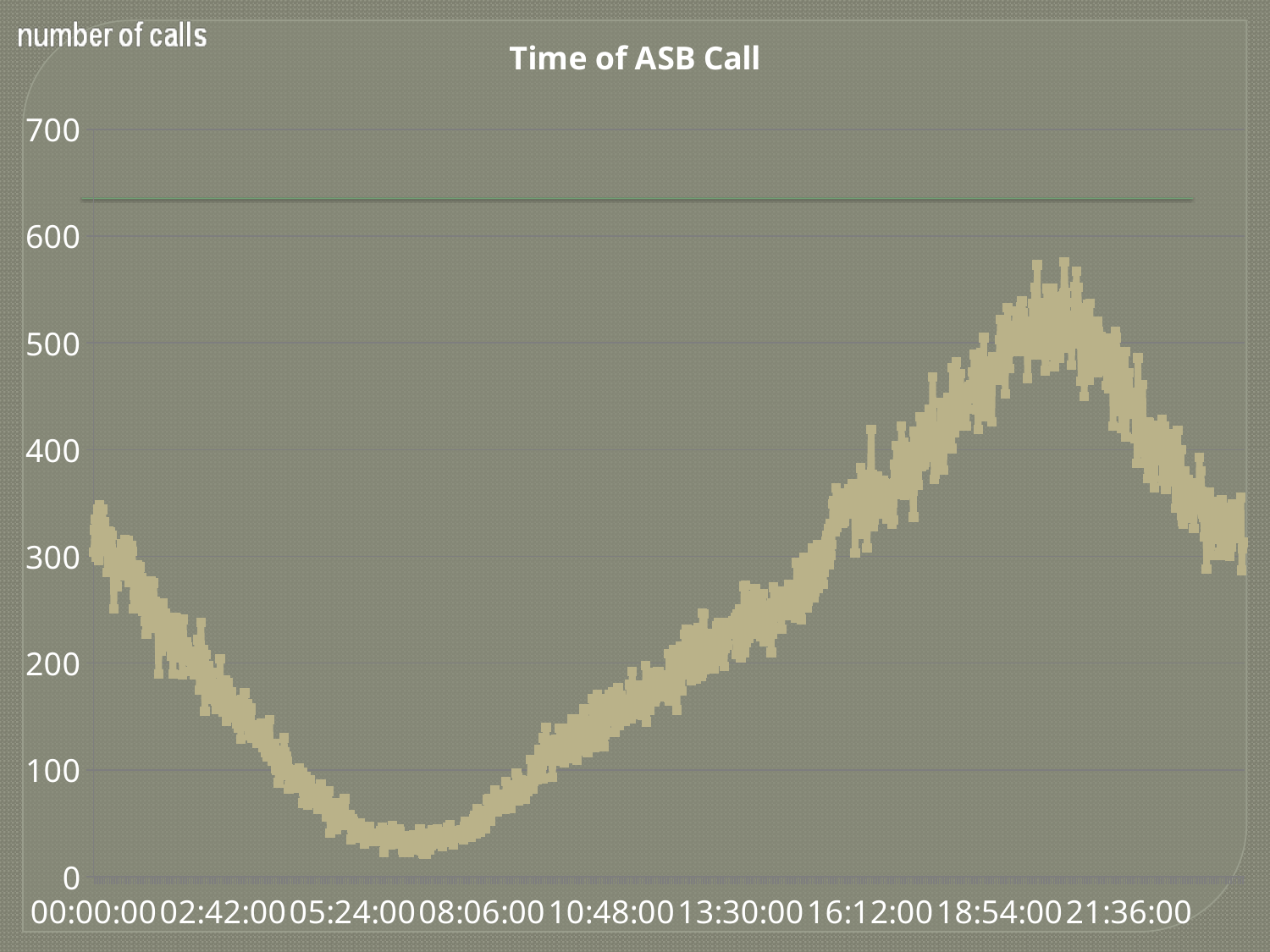
Is the number of calls at 10:48:00 greater or less than 200? less Does the number of calls rise or fall between 08:06:00 and 18:54:00? rise What is the title of the chart? Time of ASB Call Which of the labelled times, 05:24:00 or 18:54:00, has the higher number of calls? 18:54:00 Is the number of calls at 18:54:00 greater or less than 400? greater What label is shown for the vertical axis of the chart? number of calls What is the highest value shown on the vertical axis? 700 Does the number of calls rise or fall between 00:00:00 and 05:24:00? fall Is the number of calls at 05:24:00 greater or less than 100? less How many time labels are shown along the horizontal axis? 9 What kind of chart is shown on the slide? line chart